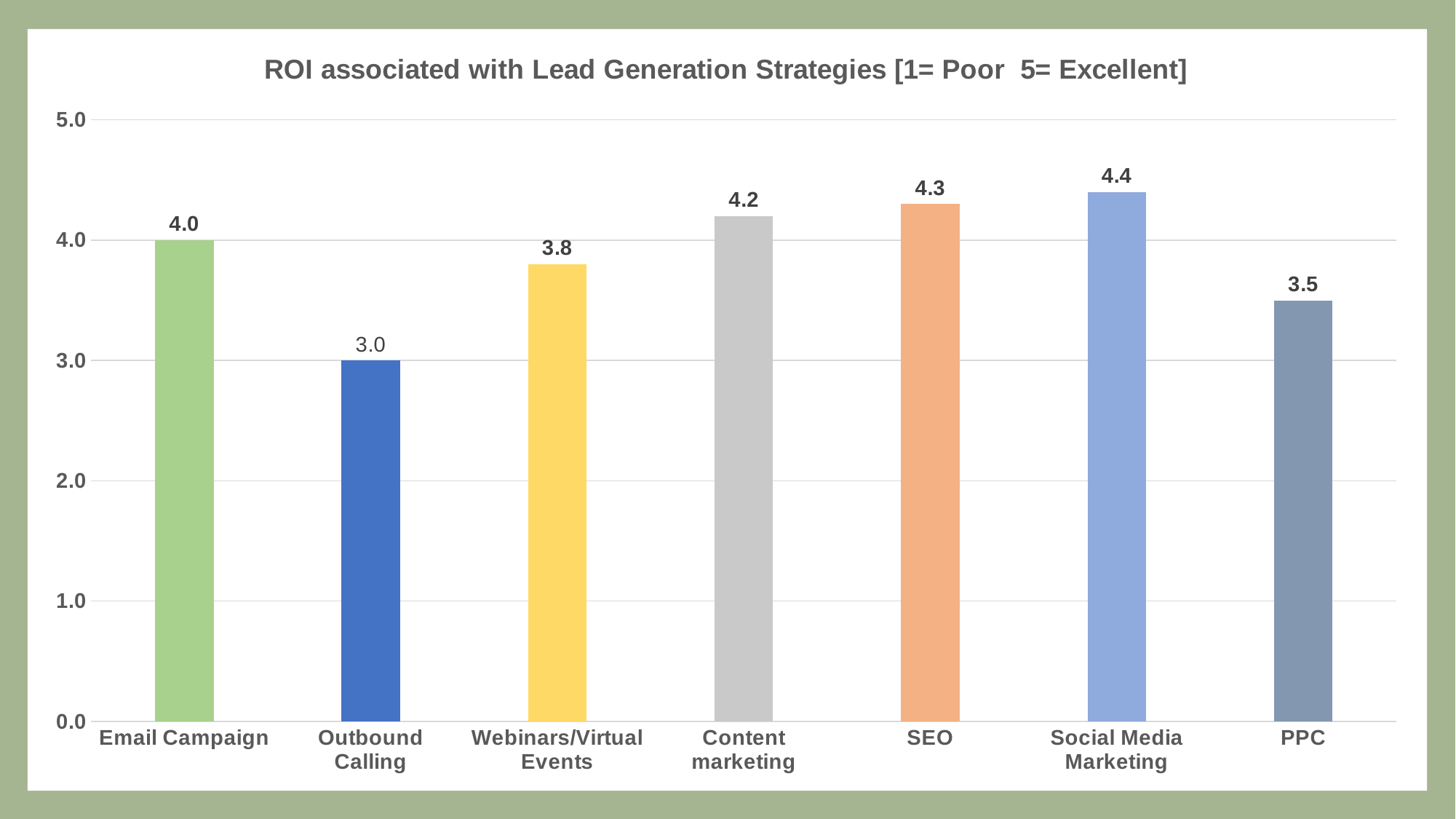
What is the ROI rating for PPC? 3.5 What is the ROI rating for Email Campaign? 4.0 What is the ROI rating for Webinars/Virtual Events? 3.8 Which has a higher ROI rating, Email Campaign or PPC? Email Campaign Which lead generation strategy has the highest ROI rating? Social Media Marketing What type of chart is shown on the slide? Bar chart What is the ROI rating for Outbound Calling? 3.0 What is the difference between the ROI ratings for Social Media Marketing and Outbound Calling? 1.4 What is the difference between the ROI ratings for SEO and Content marketing? 0.1 Which lead generation strategy has the lowest ROI rating? Outbound Calling How many lead generation strategies are shown in the chart? 7 What is the title of the chart? ROI associated with Lead Generation Strategies [1= Poor 5= Excellent]